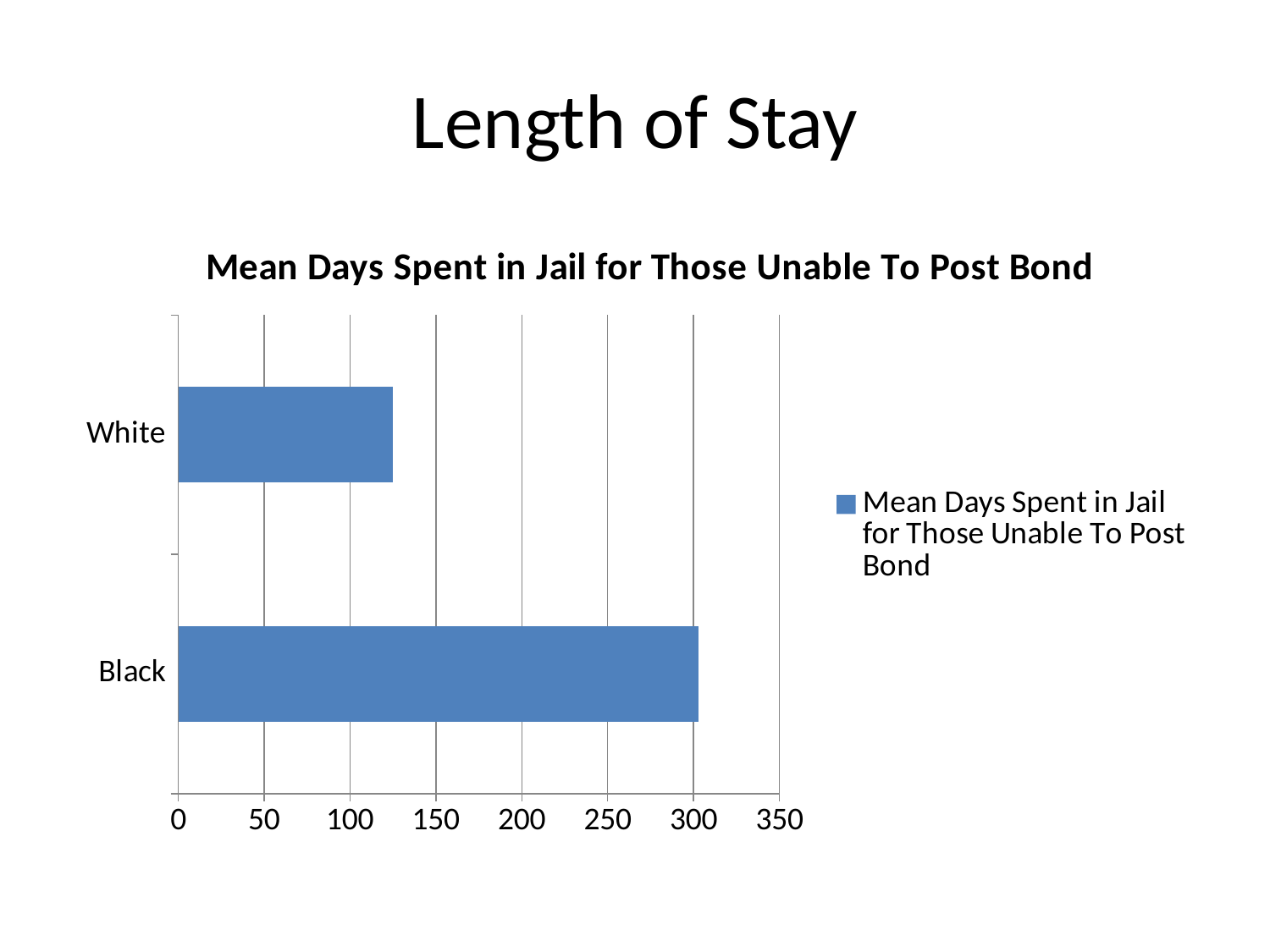
Which category has the lowest mean days spent in jail? White Which category has the highest mean days spent in jail? Black Is the value for Black greater or less than 350? less Is the value for White greater or less than 100? greater What is the maximum value shown on the horizontal axis? 350 Which is larger, the value for Black or the value for White? Black How many categories are shown on the chart? 2 How many series does the legend list? 1 Is the value for White greater or less than 150? less What kind of chart is shown on the slide? bar chart What is the title of the chart? Mean Days Spent in Jail for Those Unable To Post Bond